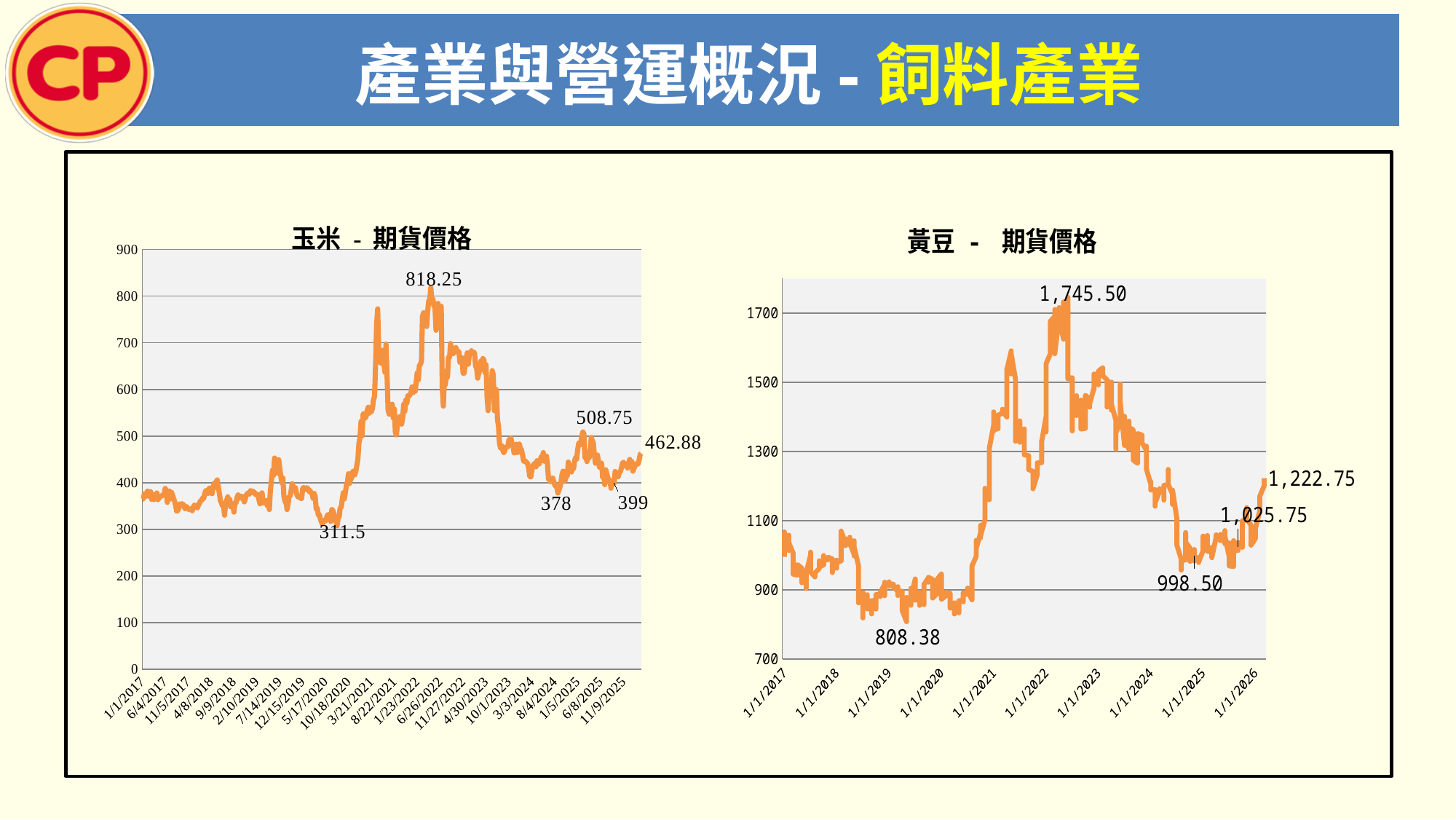
In the 黃豆 - 期貨價格 chart, what is the highest labelled value? 1,745.50 In the 黃豆 - 期貨價格 chart, what is the difference between the peak label 1,745.50 and the low label 808.38? 937.12 In the 黃豆 - 期貨價格 chart, what is the lowest labelled value? 808.38 What is the title of the chart on the right side of the slide? 黃豆 - 期貨價格 In the 玉米 - 期貨價格 chart, what is the last labelled value at the right end of the line? 462.88 In the 玉米 - 期貨價格 chart, what is the difference between the peak label 818.25 and the low label 311.5? 506.75 In the 玉米 - 期貨價格 chart, what is the highest labelled value? 818.25 What kind of chart is the 玉米 - 期貨價格 chart? line chart In the 玉米 - 期貨價格 chart, what is the lowest labelled value? 311.5 In the 玉米 - 期貨價格 chart, which labelled value is larger, 508.75 or 399? 508.75 In the 黃豆 - 期貨價格 chart, what is the last labelled value at the right end of the line? 1,222.75